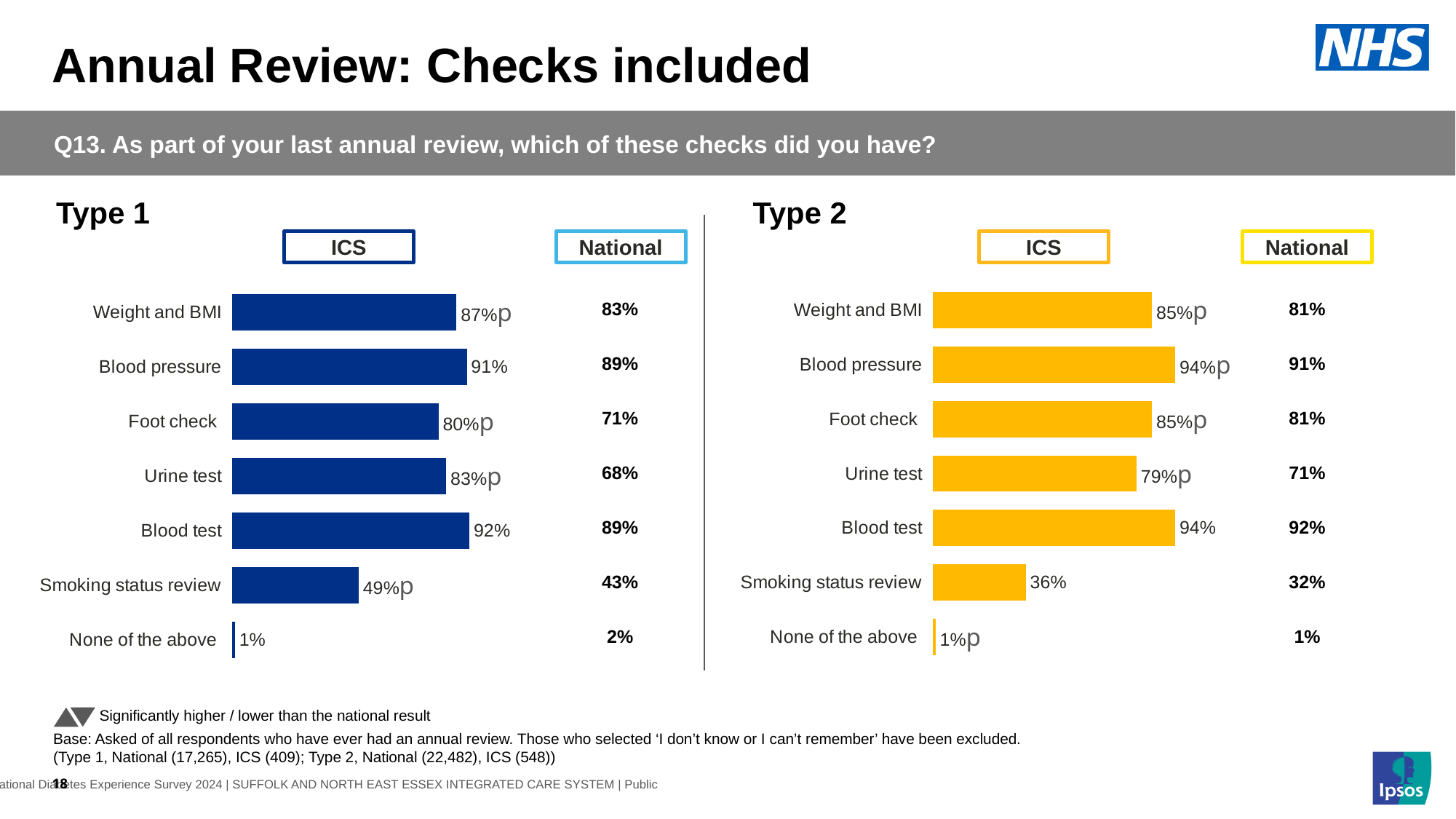
In the Type 1 chart, which check has the highest ICS value? Blood test What colour are the ICS bars in the Type 2 chart? Yellow What type of chart is used for the Type 2 ICS results? Bar chart In the Type 1 chart, what is the ICS value for Foot check? 80% In the Type 2 chart, what is the difference between the ICS values for Blood pressure and Smoking status review? 58 percentage points How many checks are listed in the Type 1 chart? 7 In the Type 2 chart, what is the ICS value for Urine test? 79% In the Type 2 chart, what is the National value for Blood test? 92% In the Type 1 chart, what is the difference between the ICS and National values for Urine test? 15 percentage points In the Type 2 chart, which category has the lowest ICS value? None of the above In the Type 2 chart, which is larger for Weight and BMI: the ICS value or the National value? ICS In the Type 1 chart, what is the National value for Smoking status review? 43%